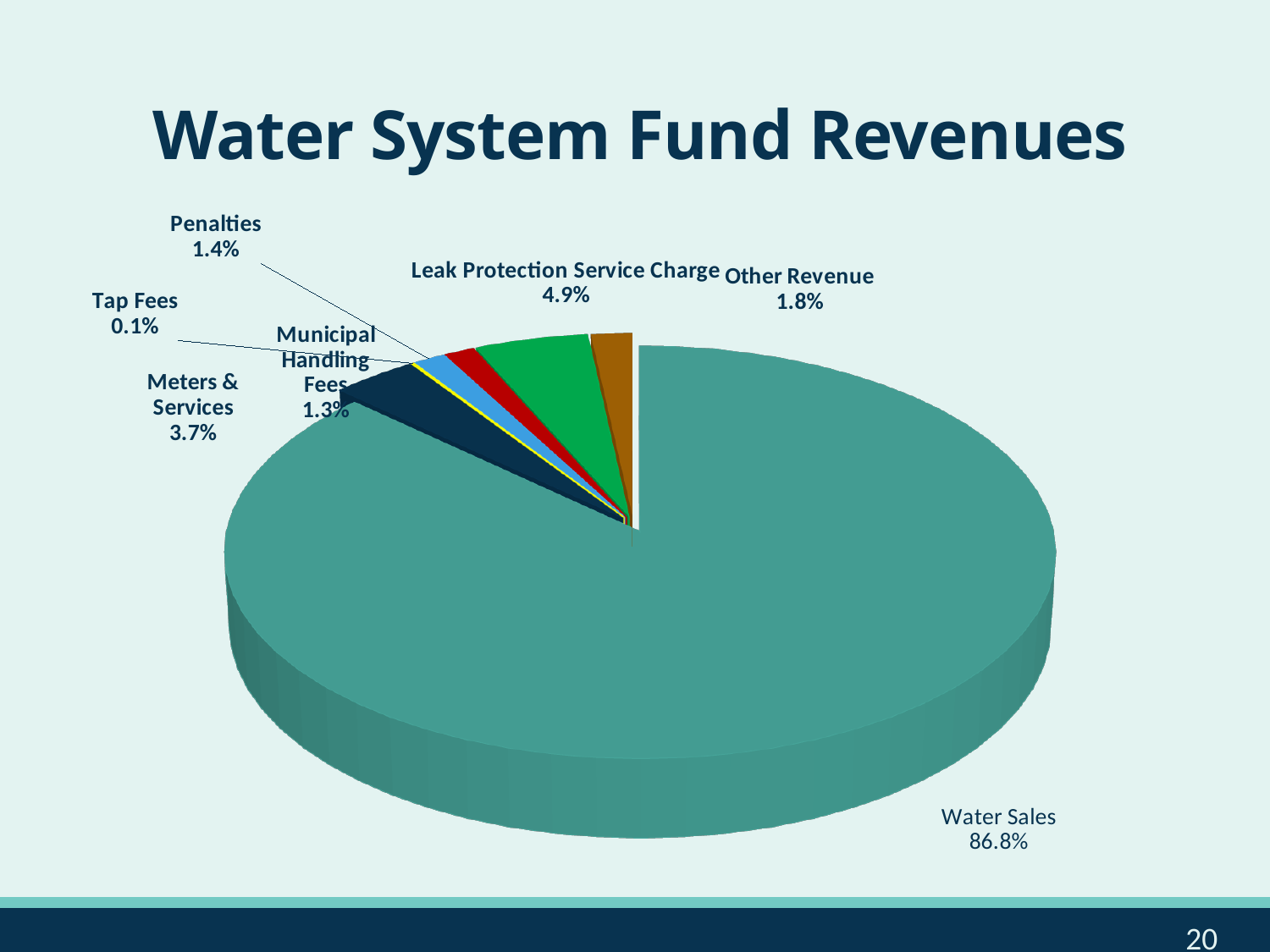
Which category has the largest share of the pie? Water Sales What kind of chart is shown on the slide? Pie chart What is the difference in percentage points between Leak Protection Service Charge and Meters & Services? 1.2% What percentage is shown for the Leak Protection Service Charge slice? 4.9% Which category has the smallest share of the pie? Tap Fees What is the combined share of Penalties and Tap Fees? 1.5% What is the title of the chart? Water System Fund Revenues What percentage is shown for Meters & Services? 3.7% What percentage is shown for Municipal Handling Fees? 1.3% Which is larger, Other Revenue or Penalties? Other Revenue How many slices does the pie chart have? 7 What share of Water System Fund Revenues comes from Water Sales? 86.8%